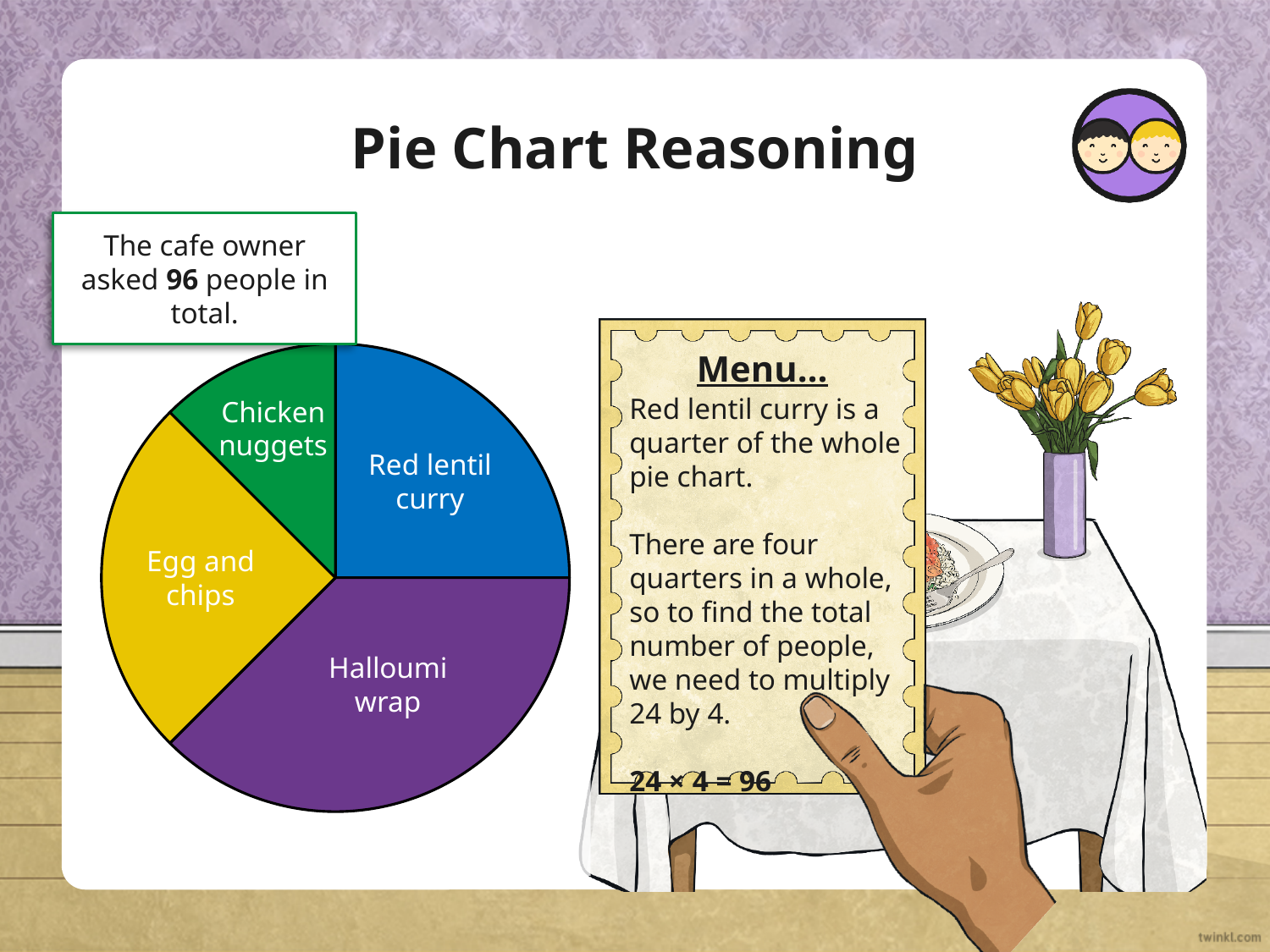
How many people chose Red lentil curry? 24 How many people in total did the cafe owner ask? 96 Which menu item has the smallest slice of the pie chart? Chicken nuggets Which slice is larger, Halloumi wrap or Chicken nuggets? Halloumi wrap How many slices does the pie chart have? 4 Which slice is larger, Halloumi wrap or Red lentil curry? Halloumi wrap What colour is the Egg and chips slice? yellow Which slice is larger, Egg and chips or Chicken nuggets? Egg and chips Which menu item has the largest slice of the pie chart? Halloumi wrap What is the title of the slide containing the pie chart? Pie Chart Reasoning What fraction of the pie chart does Red lentil curry represent? a quarter What kind of chart is shown on the slide? pie chart